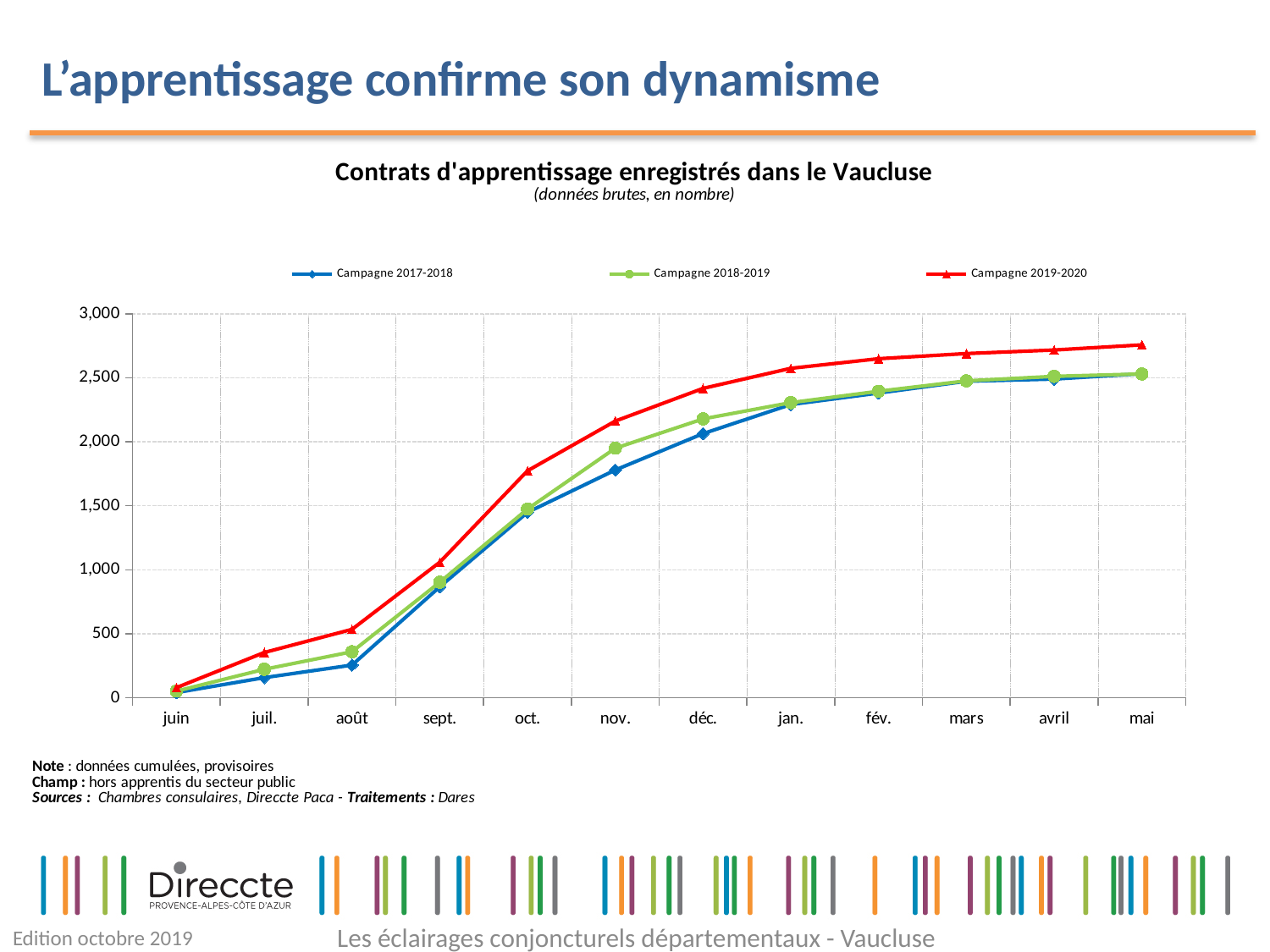
Is the value for Campagne 2019-2020 in déc. greater or less than 2,500? less Is the value for Campagne 2018-2019 in août greater or less than 500? less Which series has the lowest value in nov.? Campagne 2017-2018 Is the value for Campagne 2019-2020 in mai greater or less than 2,500? greater What kind of chart is shown on the slide? line chart Which series has the highest value in mai? Campagne 2019-2020 How many months are shown along the x axis? 12 In nov., which is larger: the value for Campagne 2019-2020 or for Campagne 2017-2018? Campagne 2019-2020 What is the title of the chart? Contrats d'apprentissage enregistrés dans le Vaucluse How many series does the legend list? 3 Do the values for Campagne 2019-2020 rise or fall from juin to mai? rise